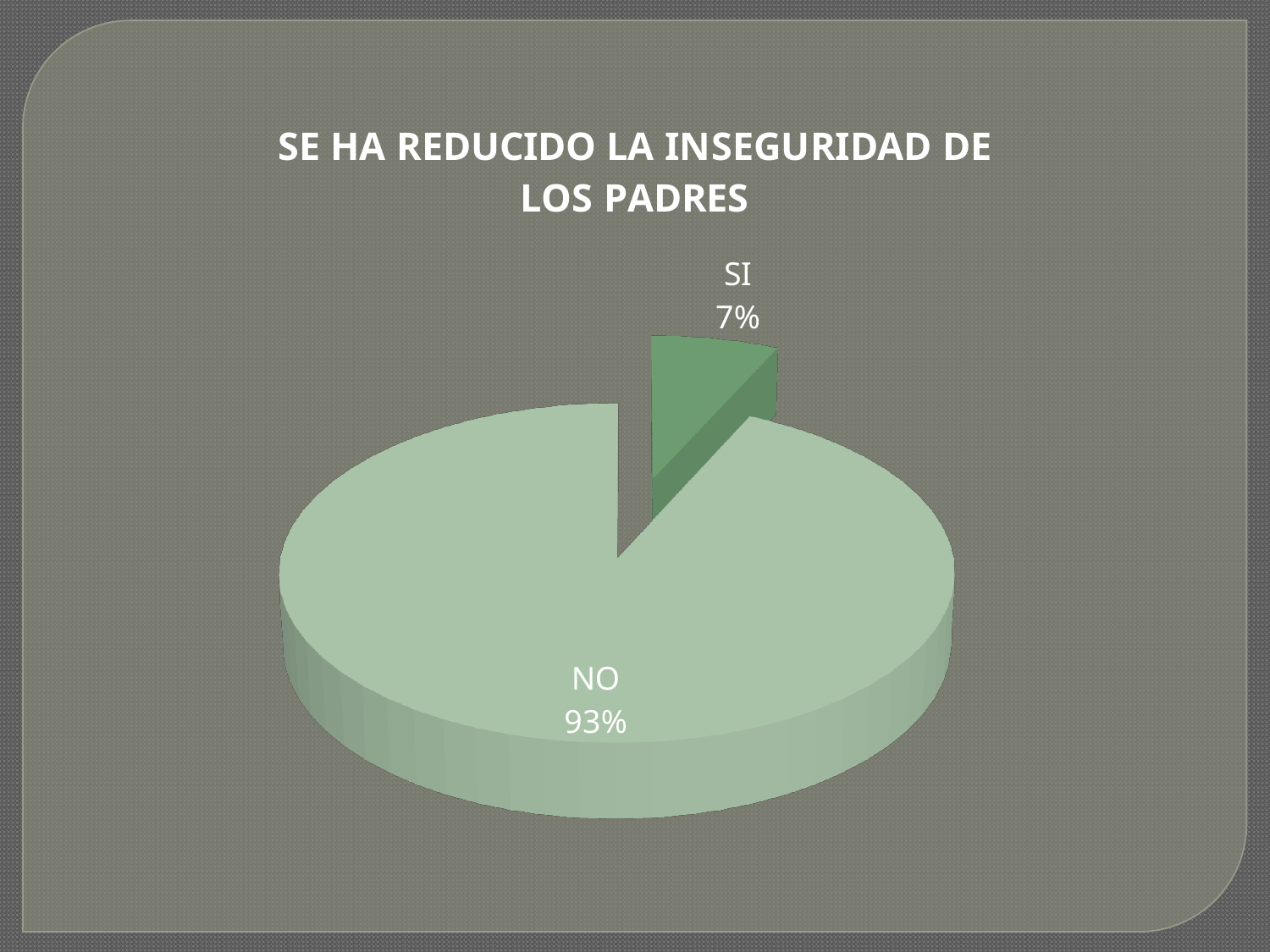
How many slices does the pie chart have? 2 Which slice is shown in the darker green colour? SI Which is larger, the SI slice or the NO slice? NO What is the title of the chart? SE HA REDUCIDO LA INSEGURIDAD DE LOS PADRES What type of chart is shown on the slide? pie chart What percentage does the NO slice represent? 93% Which category has the smallest share of the pie? SI What is the difference in percentage points between the NO and SI slices? 86 What share of the pie does the NO slice take? 93% Which category has the largest share of the pie? NO What percentage does the SI slice represent? 7%